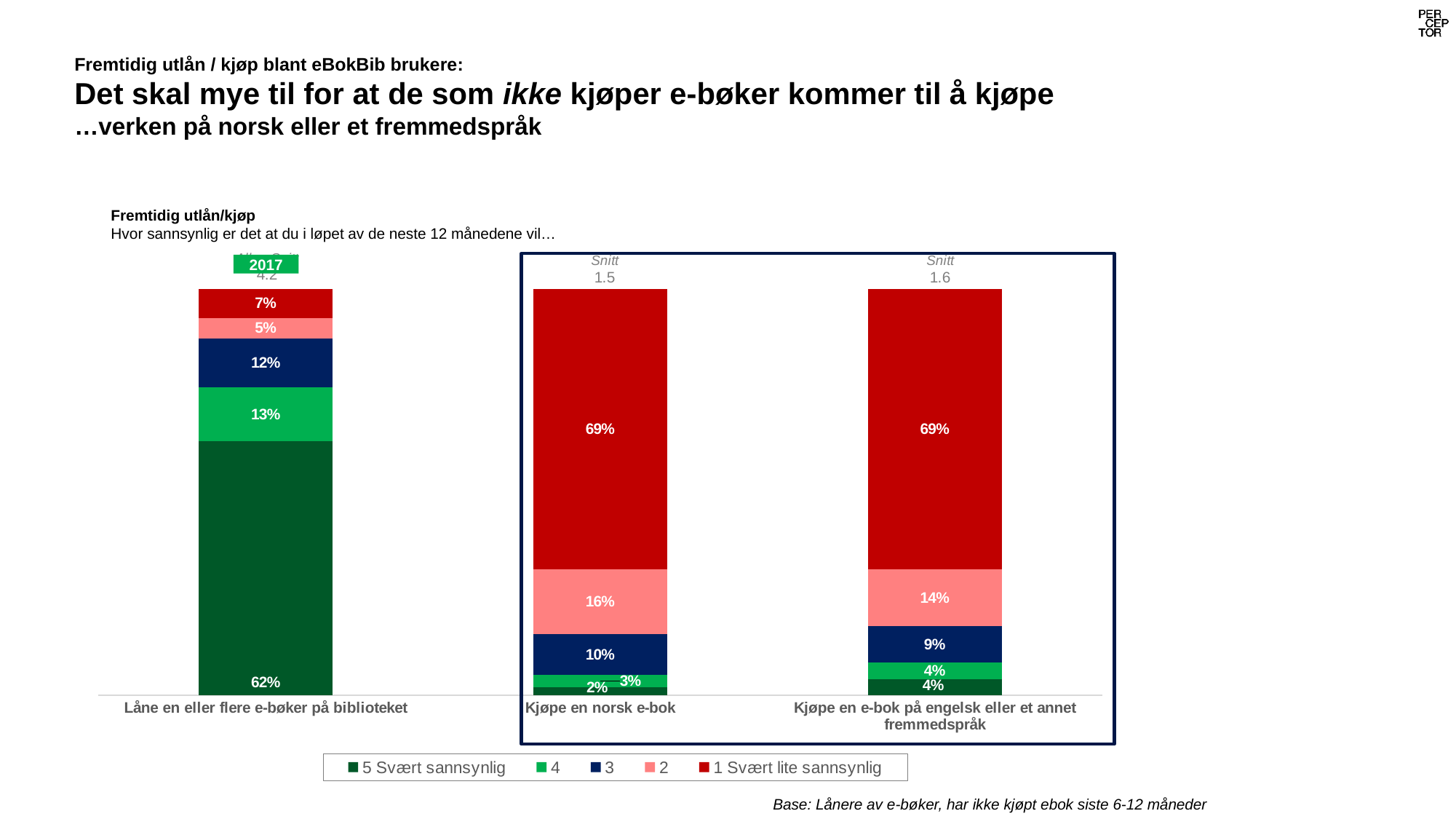
How many categories are shown along the x axis of the chart? 3 How many series does the legend list? 5 Which category has the highest value for '5 Svært sannsynlig'? Låne en eller flere e-bøker på biblioteket Which category has the lowest value for '5 Svært sannsynlig'? Kjøpe en norsk e-bok What is the value of '1 Svært lite sannsynlig' for 'Kjøpe en norsk e-bok'? 69% What is the difference between the '2' values for 'Kjøpe en norsk e-bok' and 'Kjøpe en e-bok på engelsk eller et annet fremmedspråk'? 2% What type of chart is shown on the slide? Stacked bar chart What is the total of the stacked bar for 'Kjøpe en norsk e-bok'? 100% What is the value of '5 Svært sannsynlig' for 'Låne en eller flere e-bøker på biblioteket'? 62% What is the 'Snitt' (average) shown above the bar for 'Kjøpe en norsk e-bok'? 1.5 What is the value of '2' for 'Kjøpe en e-bok på engelsk eller et annet fremmedspråk'? 14% Which is larger: the '3' value for 'Låne en eller flere e-bøker på biblioteket' or the '3' value for 'Kjøpe en norsk e-bok'? Låne en eller flere e-bøker på biblioteket